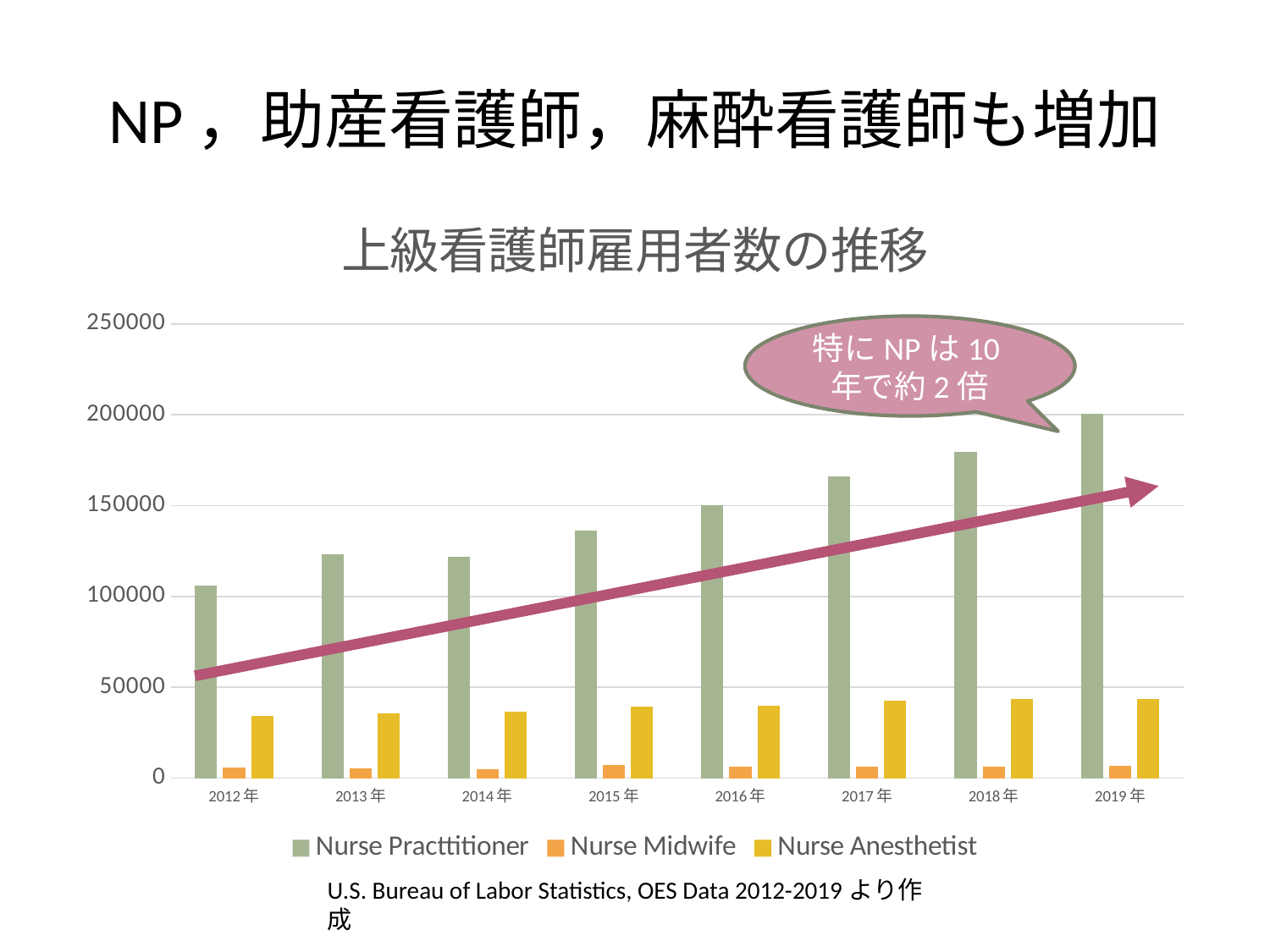
Is the Nurse Anesthetist value for 2019年 greater or less than 50000? less What type of chart is shown on the slide? bar chart In which year is the Nurse Practitioner value lowest? 2012年 In 2017年, which is larger: Nurse Practitioner or Nurse Anesthetist? Nurse Practitioner Do the Nurse Practitioner values generally rise or fall from 2012年 to 2019年? rise How many series does the legend list? 3 How many years are shown on the x axis? 8 Is the Nurse Practitioner value for 2018年 greater or less than 150000? greater In which year is the Nurse Practitioner value highest? 2019年 Which series has the lowest values across all years? Nurse Midwife What is the title of the chart? 上級看護師雇用者数の推移 Is the Nurse Practitioner value for 2013年 greater or less than 100000? greater